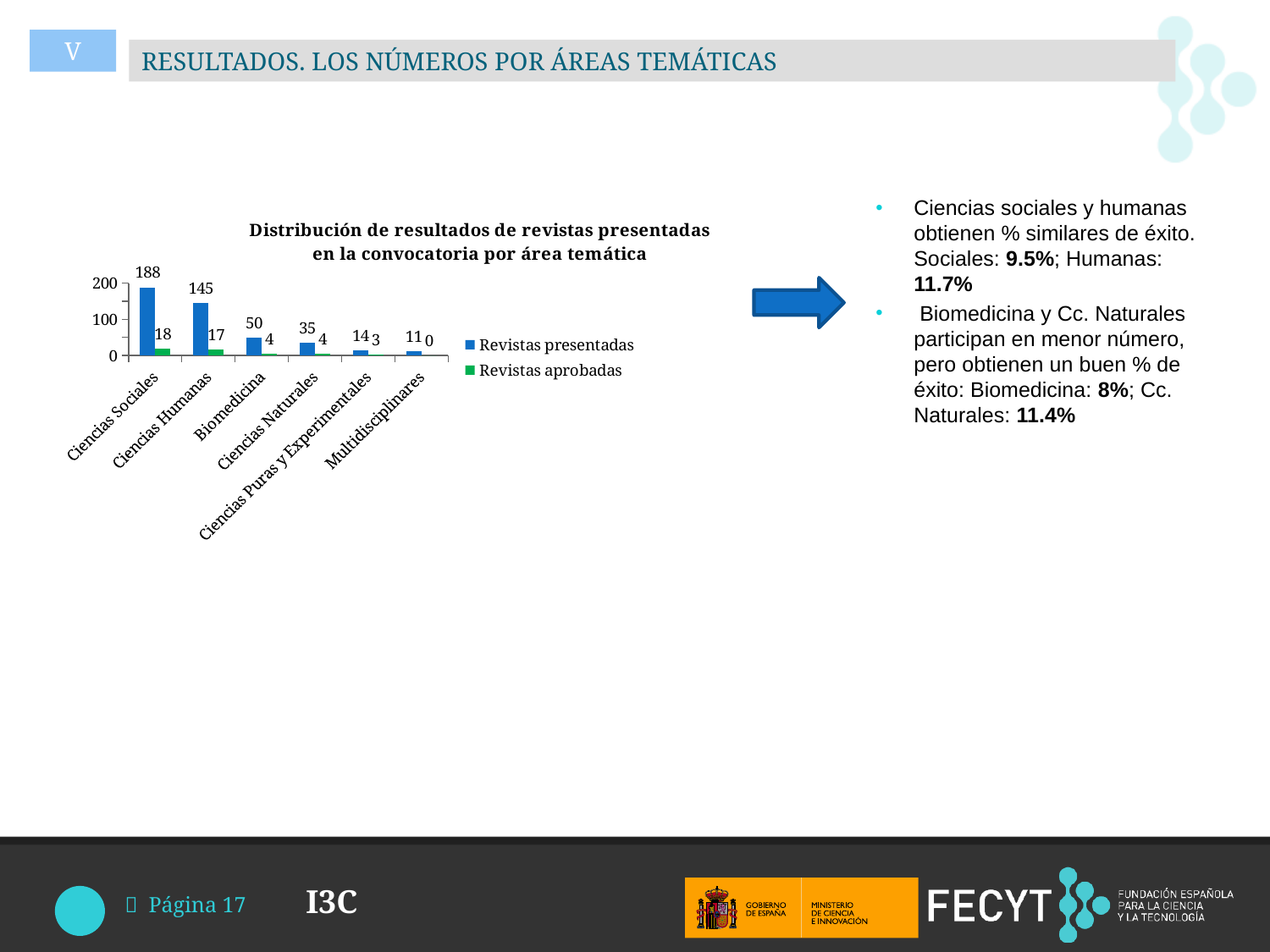
What is the value of Revistas aprobadas for Ciencias Humanas? 17 Which category has the lowest value of Revistas presentadas? Multidisciplinares What is the value of Revistas presentadas for Biomedicina? 50 What is the value of Revistas presentadas for Ciencias Sociales? 188 Which category has the highest value of Revistas presentadas? Ciencias Sociales What is the title of the chart? Distribución de resultados de revistas presentadas en la convocatoria por área temática What type of chart is shown on the slide? Bar chart What is the difference between Revistas presentadas for Ciencias Sociales and Ciencias Humanas? 43 How many categories (áreas temáticas) are shown on the x axis? 6 Which is larger: Revistas presentadas for Ciencias Naturales or for Ciencias Puras y Experimentales? Ciencias Naturales How many series does the legend list? 2 What is the value of Revistas aprobadas for Multidisciplinares? 0